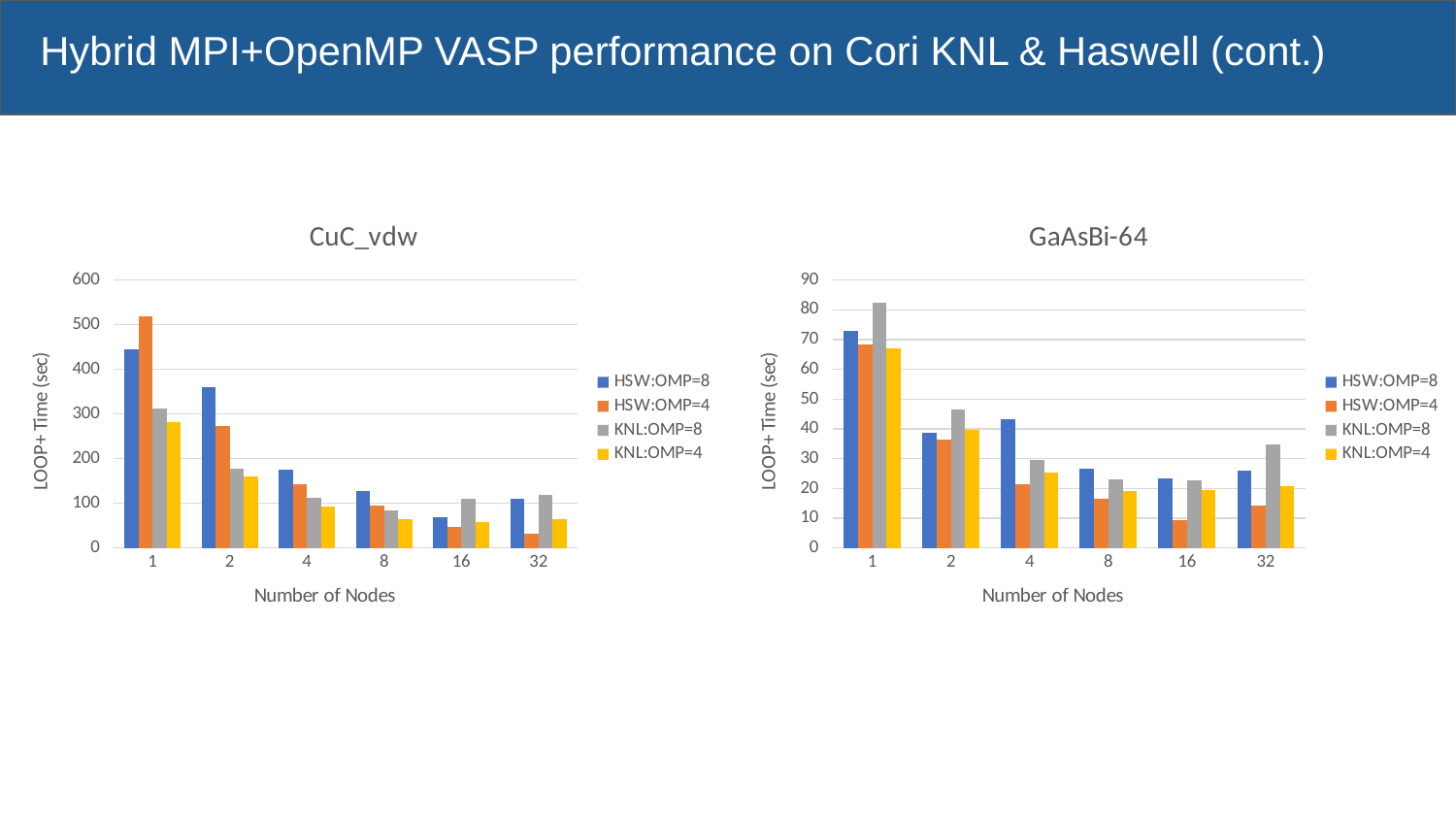
How many series does the legend of the GaAsBi-64 chart list? 4 What is the x-axis title of the CuC_vdw chart? Number of Nodes In the CuC_vdw chart, does the HSW:OMP=4 series rise or fall as the number of nodes increases? fall In the GaAsBi-64 chart, is the value for KNL:OMP=8 at 1 node greater or less than 70? greater In the GaAsBi-64 chart, which series has the lowest LOOP+ time at 16 nodes? HSW:OMP=4 In the CuC_vdw chart, is the value for HSW:OMP=4 at 1 node greater or less than 500? greater What is the y-axis title of the GaAsBi-64 chart? LOOP+ Time (sec) In the CuC_vdw chart at 32 nodes, which is larger: HSW:OMP=4 or KNL:OMP=8? KNL:OMP=8 In the GaAsBi-64 chart, is the value for HSW:OMP=4 at 4 nodes greater or less than 30? less In the CuC_vdw chart, which series has the highest LOOP+ time at 1 node? HSW:OMP=4 How many node counts are shown on the x axis of the CuC_vdw chart? 6 What kind of chart is the CuC_vdw chart? bar chart